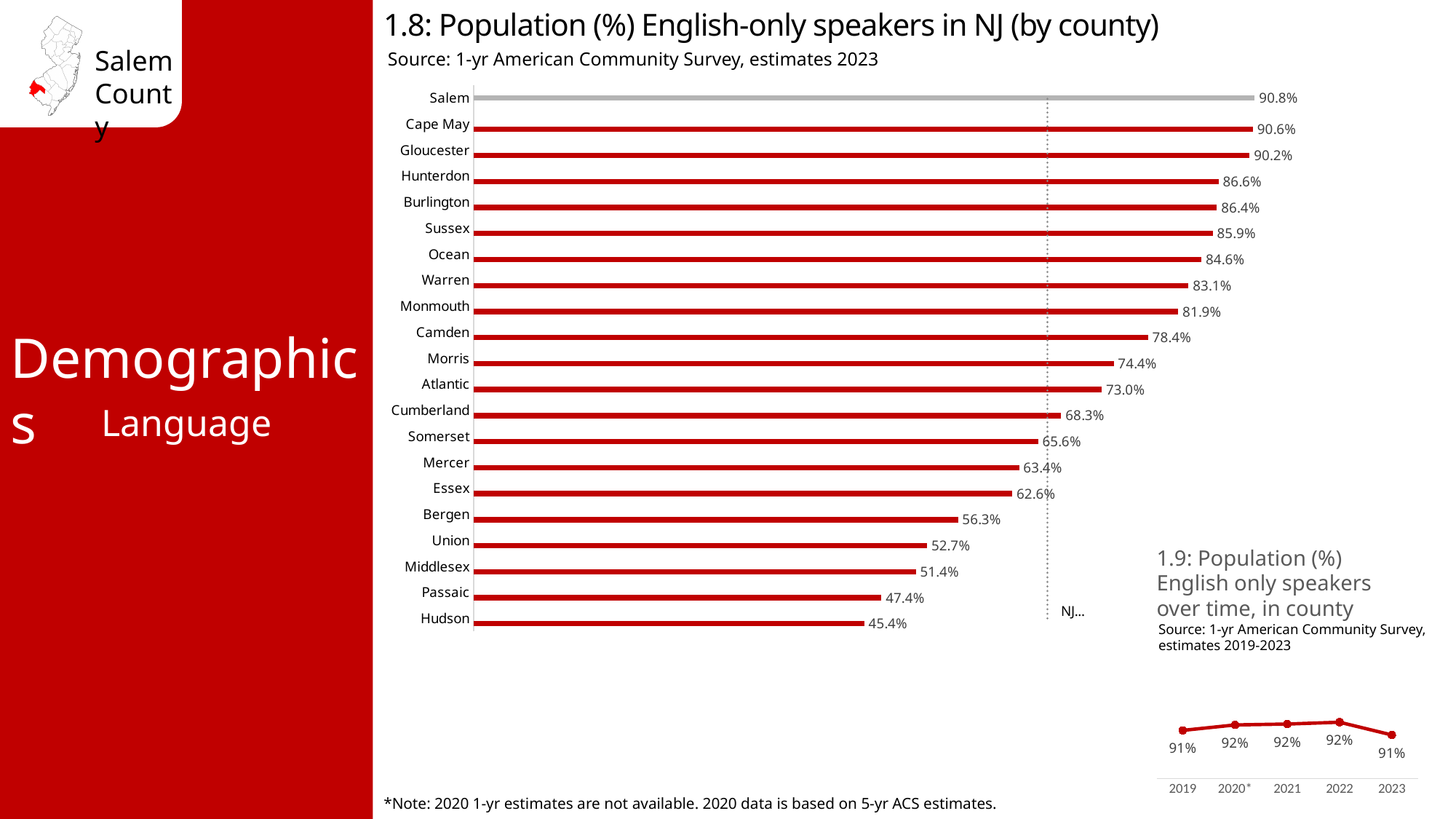
In chart 1.8 (English-only speakers by county), what colour is the bar for Salem? Grey In chart 1.8 (English-only speakers by county), which is larger, the value for Camden or the value for Morris? Camden In chart 1.8 (English-only speakers by county), how many counties are plotted? 21 What kind of chart is chart 1.8 (English-only speakers by county)? Bar chart In chart 1.8 (English-only speakers by county), what is the value for Salem? 90.8% What kind of chart is chart 1.9 (English only speakers over time, in county)? Line chart In chart 1.8 (English-only speakers by county), what is the value for Cumberland? 68.3% In chart 1.9 (English only speakers over time, in county), what is the value for 2022? 92% In chart 1.8 (English-only speakers by county), which county has the highest value? Salem In chart 1.9 (English only speakers over time, in county), how many years are plotted? 5 In chart 1.8 (English-only speakers by county), which county has the lowest value? Hudson In chart 1.8 (English-only speakers by county), what is the difference between Salem and Hudson? 45.4%